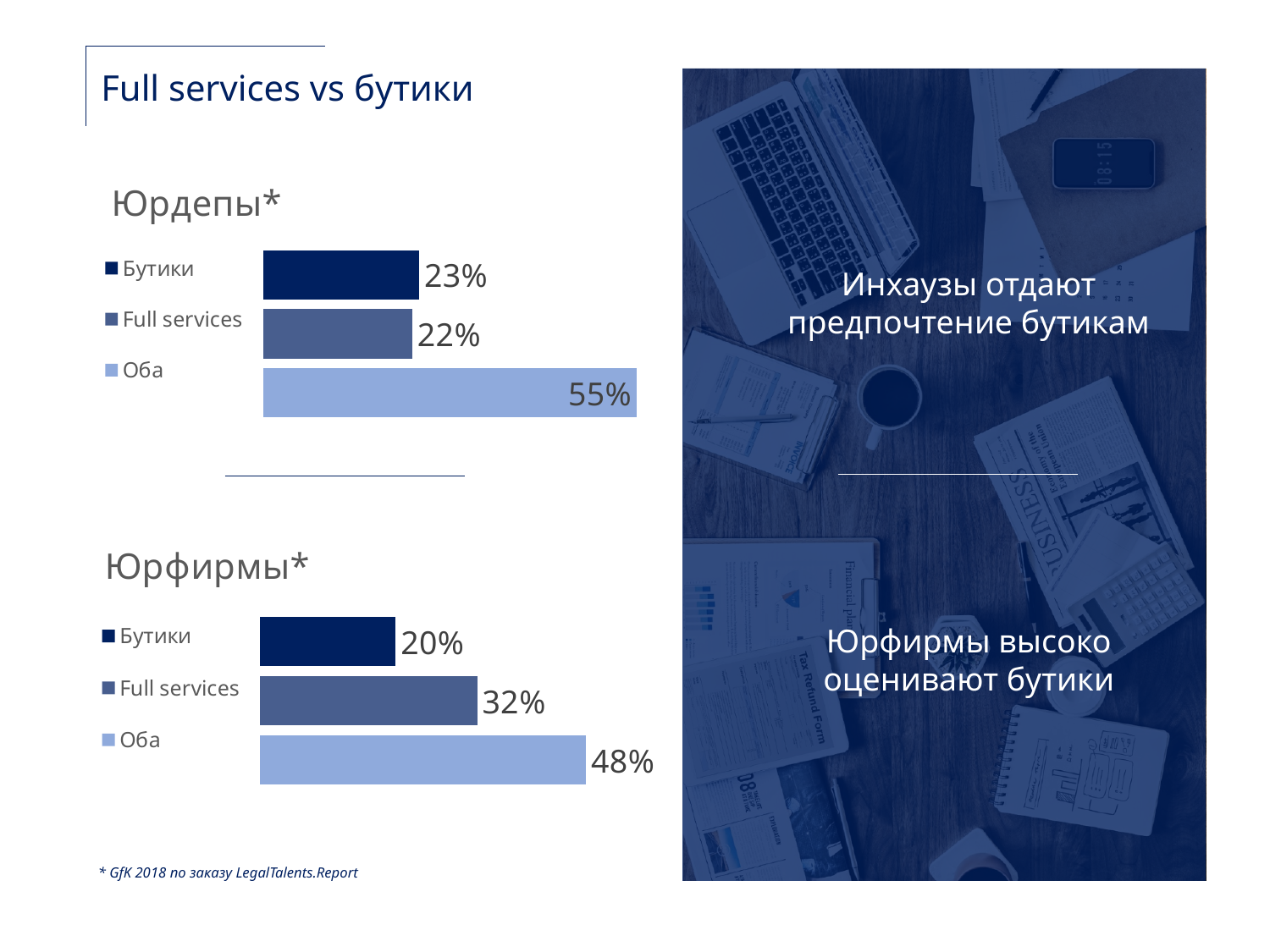
In the Юрфирмы* chart, what is the difference between Оба and Full services? 16% In the Юрфирмы* chart, which category has the lowest value? Бутики In the Юрфирмы* chart, what is the value for Full services? 32% In the Юрдепы* chart, what is the value for Оба? 55% In the Юрдепы* chart, which category has the highest value? Оба How many entries does the legend of the Юрфирмы* chart list? 3 In the Юрфирмы* chart, what is the value for Бутики? 20% In the Юрдепы* chart, what is the difference between Бутики and Full services? 1% How many categories are shown in the Юрдепы* chart? 3 In the Юрдепы* chart, what is the value for Бутики? 23% What kind of chart is the Юрфирмы* chart? Bar chart In the Юрфирмы* chart, which is larger: Full services or Бутики? Full services